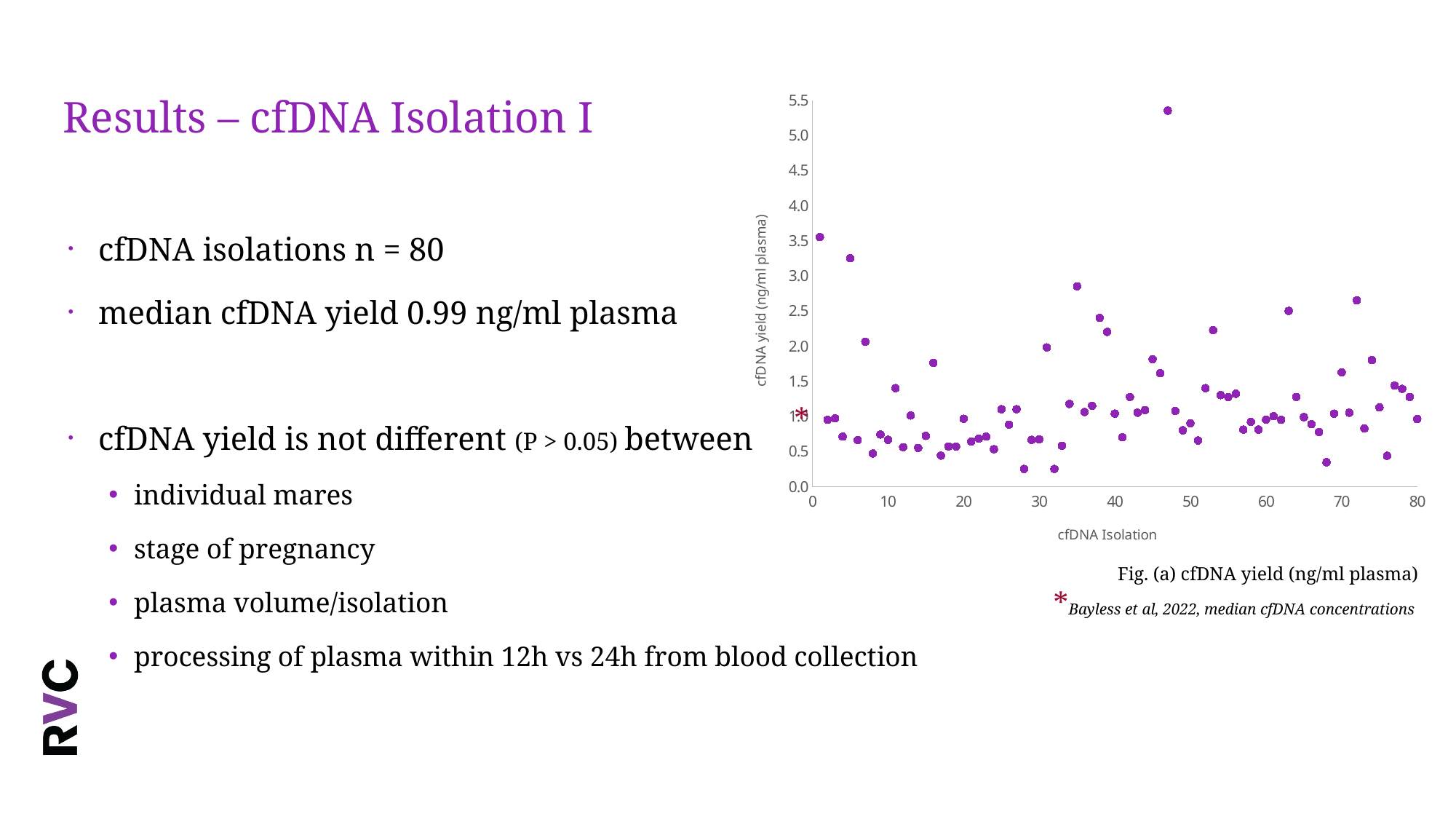
Is the highest cfDNA yield value in the chart greater or less than 5.0 ng/ml plasma? greater Do the cfDNA yield values show a clear rising or falling trend along the x axis? No clear trend Is the cfDNA yield for the isolation at x = 47 greater or less than 4.5? greater Are most of the plotted cfDNA yield values above or below 2.0 ng/ml plasma? below What kind of chart is shown on the slide? Scatter plot What is the highest value shown on the y axis of the chart? 5.5 What is the label of the x axis of the chart? cfDNA Isolation How many cfDNA isolations are plotted in the chart? 80 What is the label of the y axis of the chart? cfDNA yield (ng/ml plasma)